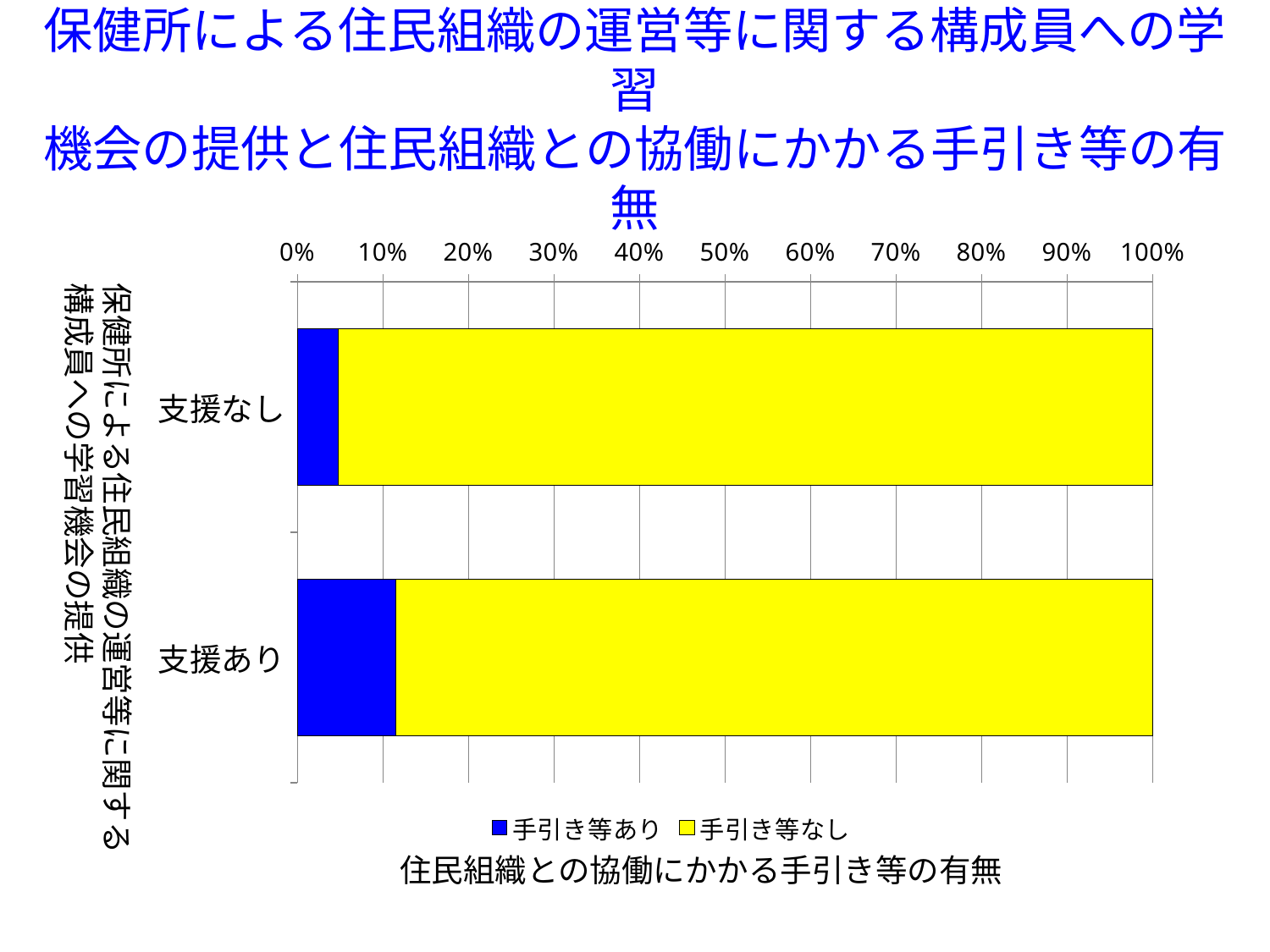
Which category has the lowest share of 手引き等あり? 支援なし What is the title shown below the chart's legend? 住民組織との協働にかかる手引き等の有無 Is the 手引き等あり share for 支援なし greater or less than 10%? less Is the 手引き等なし share for 支援なし greater or less than 90%? greater How many categories are shown on the vertical axis of the chart? 2 Is the 手引き等なし share for 支援あり greater or less than 80%? greater Which category has the highest share of 手引き等あり? 支援あり Which category has the larger share of 手引き等あり, 支援あり or 支援なし? 支援あり How many series does the chart's legend list? 2 Which colour represents the 手引き等あり series in the chart? blue What kind of chart is shown on the slide? bar chart